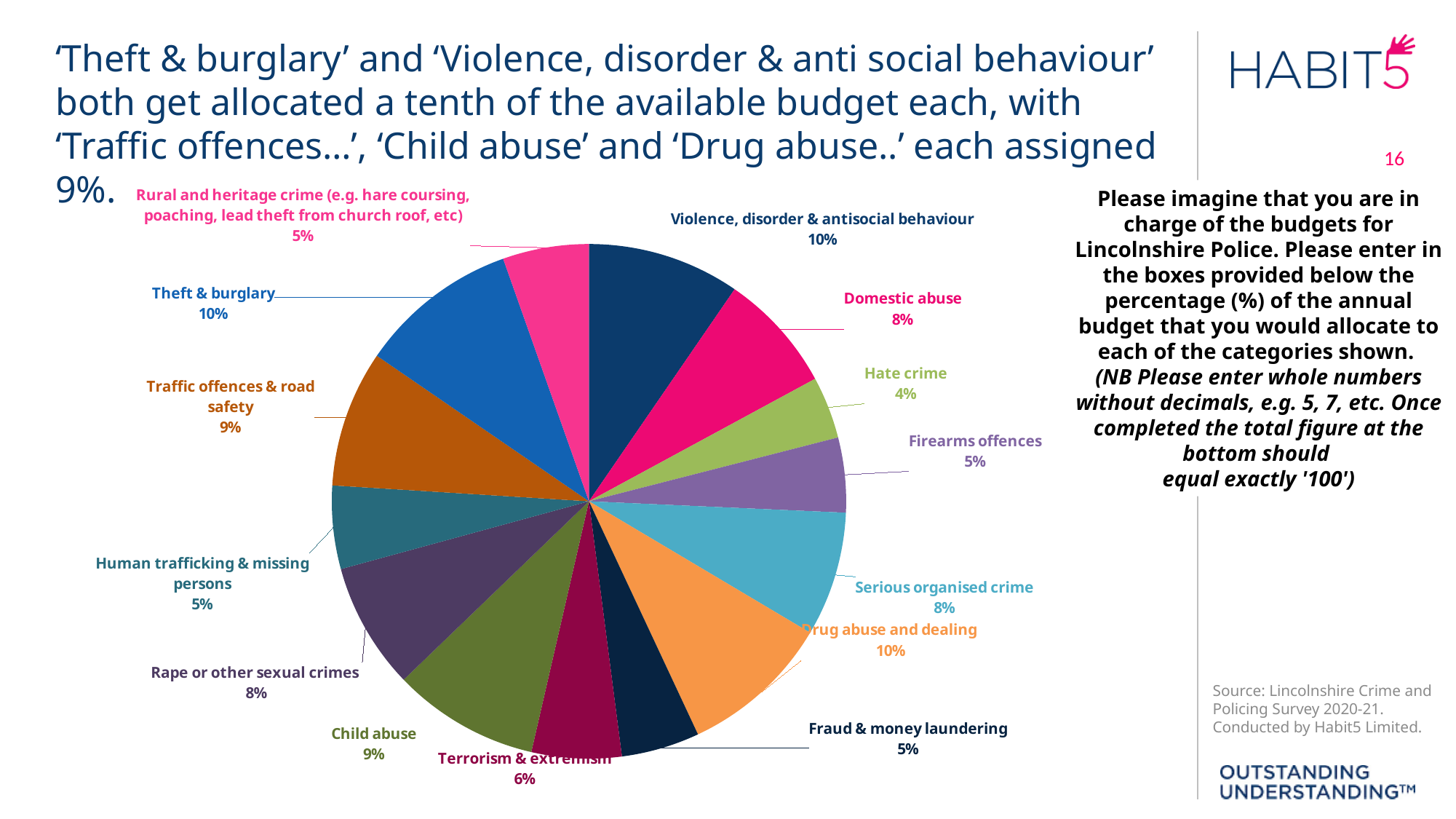
Which receives a larger share of the budget, Drug abuse and dealing or Rape or other sexual crimes? Drug abuse and dealing Which category receives the smallest share of the budget? Hate crime What is the difference between the shares for Theft & burglary and Hate crime? 6% Which receives a larger share of the budget, Domestic abuse or Firearms offences? Domestic abuse How many categories are shown in the pie chart? 14 What kind of chart is shown on the slide? pie chart What percentage of the budget is allocated to Fraud & money laundering? 5% What percentage of the budget is allocated to Terrorism & extremism? 6% What is the difference between the shares for Child abuse and Terrorism & extremism? 3% What percentage of the budget is allocated to Hate crime? 4% What percentage of the budget is allocated to Serious organised crime? 8% What is the share of the budget allocated to Rural and heritage crime? 5%